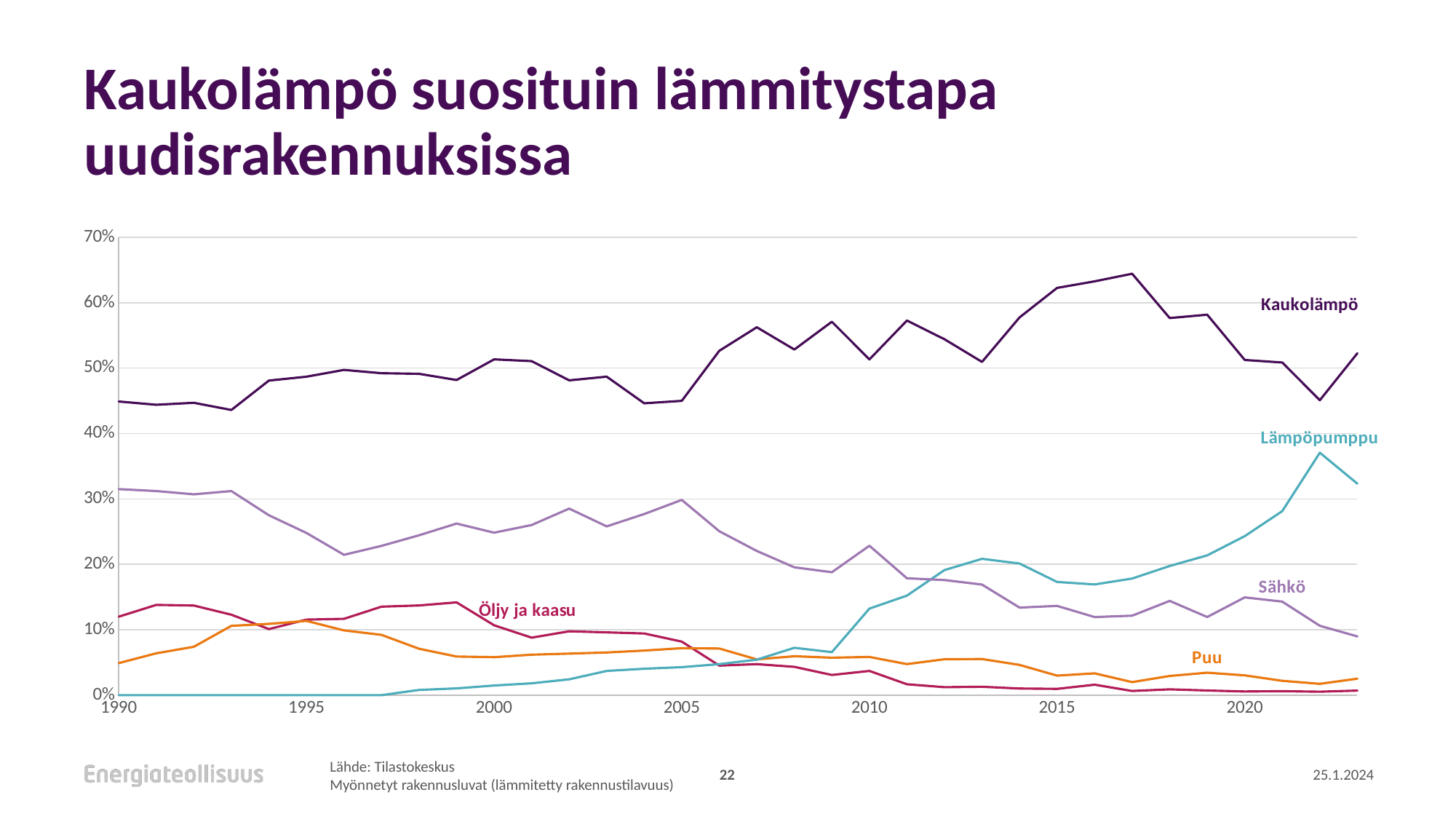
Is the value for Kaukolämpö in 2017 greater or less than 60%? greater Which series has the lowest value at the right end of the chart (2023)? Öljy ja kaasu Is the value for Puu in 2023 greater or less than 10%? less What is the title of the slide? Kaukolämpö suosituin lämmitystapa uudisrakennuksissa Is the value for Sähkö in 1990 greater or less than 30%? greater What kind of chart is shown on the slide? line chart Which series has the highest value at the right end of the chart (2023)? Kaukolämpö Which is larger in 2020: the value for Lämpöpumppu or the value for Sähkö? Lämpöpumppu How many series (lines) are plotted on the chart? 5 Does the Lämpöpumppu line generally rise or fall between 2005 and 2022? rise Which is larger in 1995: the value for Sähkö or the value for Öljy ja kaasu? Sähkö